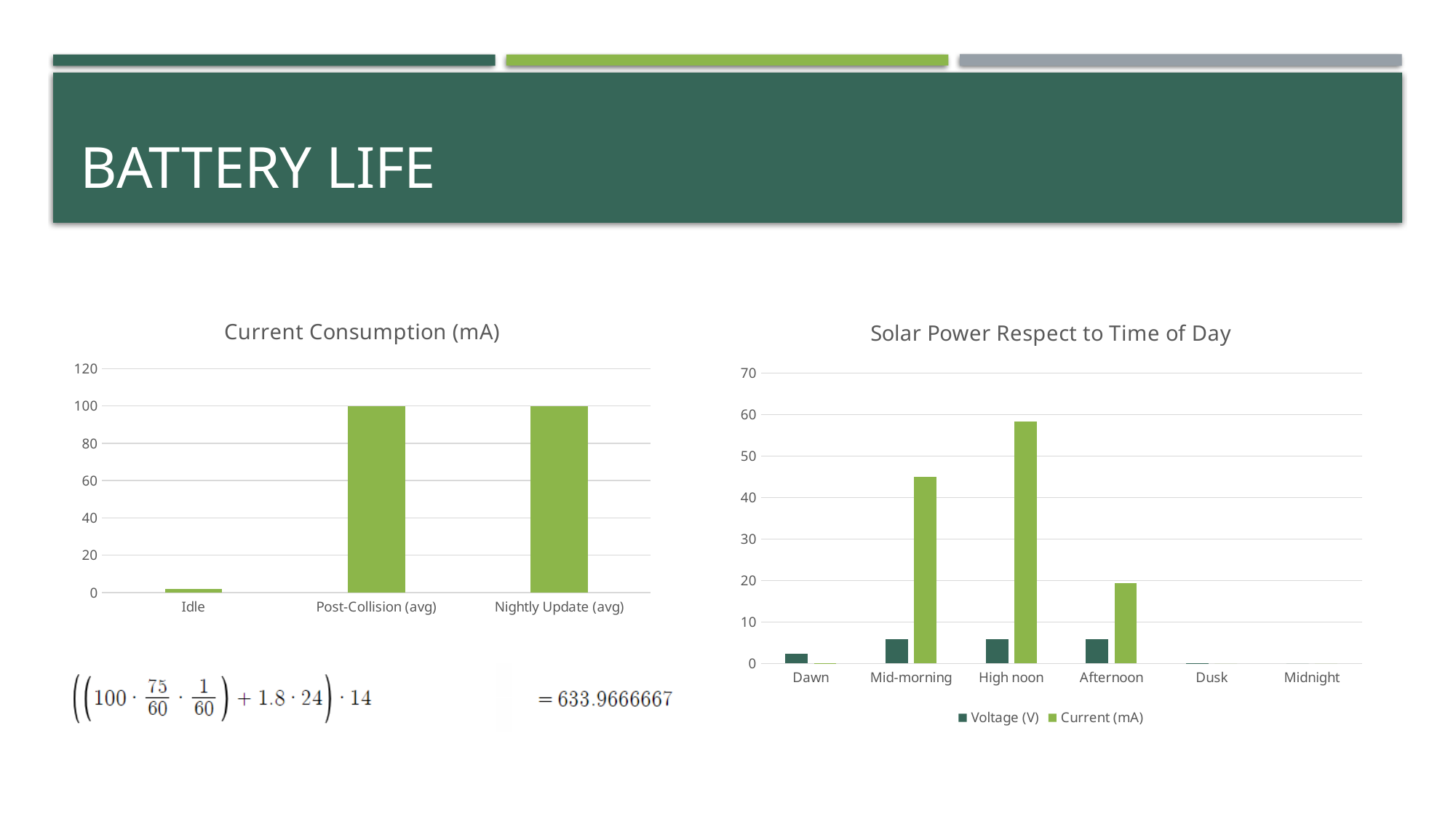
What kind of chart is the Current Consumption (mA) chart? Bar chart On the Current Consumption (mA) chart, how many categories are shown? 3 On the Solar Power Respect to Time of Day chart, how many series does the legend list? 2 On the Solar Power Respect to Time of Day chart, how many time-of-day categories are shown? 6 On the Current Consumption (mA) chart, what is the value for Nightly Update (avg)? 100 On the Current Consumption (mA) chart, what is the value for Post-Collision (avg)? 100 On the Solar Power Respect to Time of Day chart, at which time of day is Current (mA) highest? High noon On the Current Consumption (mA) chart, which category has the lowest value? Idle On the Solar Power Respect to Time of Day chart, which is larger: Current (mA) at Mid-morning or Current (mA) at Afternoon? Mid-morning On the Current Consumption (mA) chart, is the value for Idle greater or less than 20? less On the Solar Power Respect to Time of Day chart, which series is shown in light green? Current (mA) On the Solar Power Respect to Time of Day chart, is the Current (mA) value at Mid-morning greater or less than 40? greater